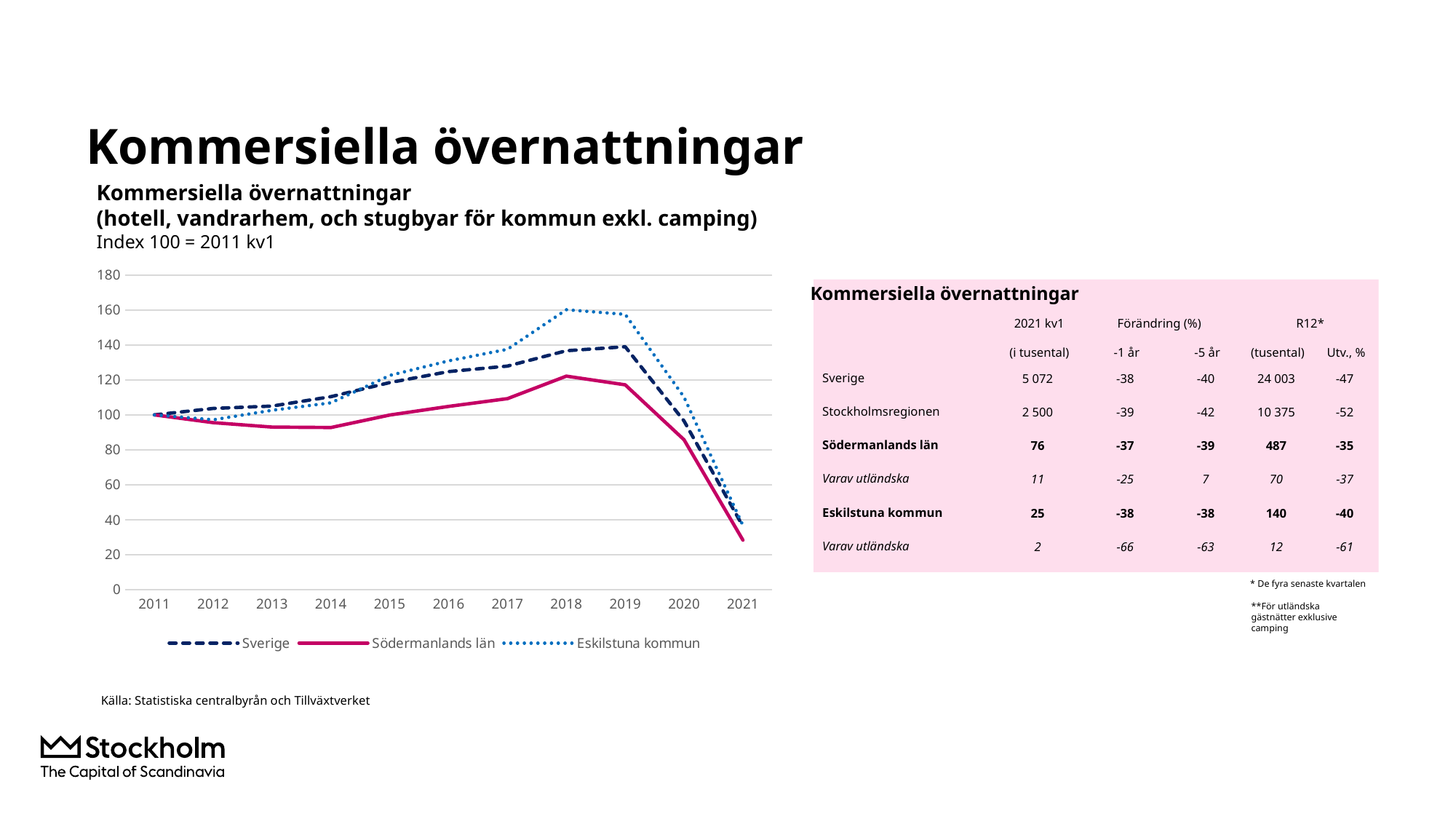
How many years are shown on the x axis of the chart? 11 Which series has the lowest value in 2021? Södermanlands län Do the values for all three series rise or fall between 2019 and 2021? fall Is the value for Södermanlands län in 2021 greater or less than 40? less How many series does the chart legend list? 3 What is the index value for Sverige in 2011? 100 Which series is drawn with a solid line in the chart? Södermanlands län What kind of chart is shown on the slide? line chart Which series has the highest value in 2018? Eskilstuna kommun Is the value for Södermanlands län in 2014 greater or less than 100? less Is the value for Sverige in 2019 greater or less than 120? greater